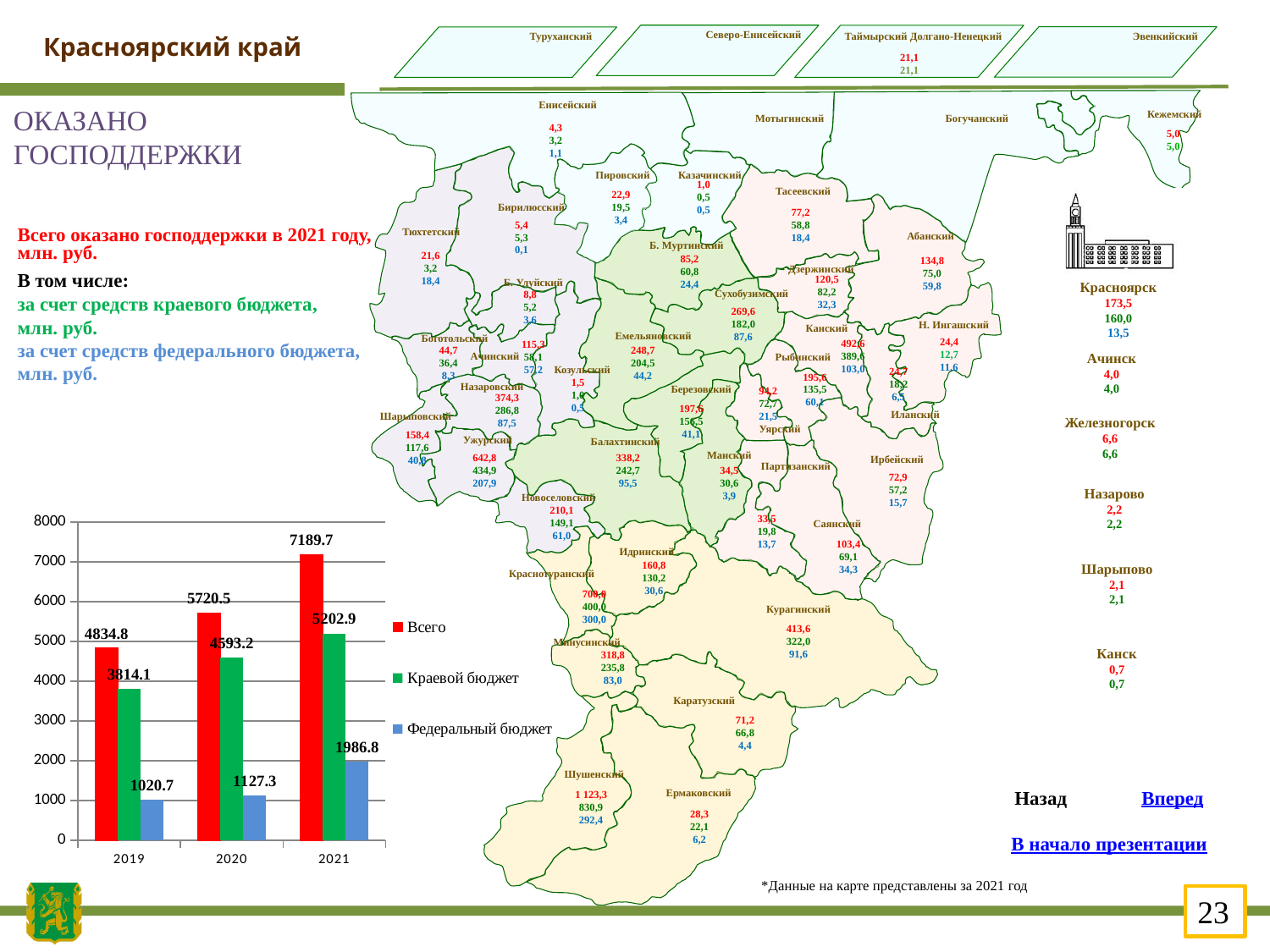
How many years are shown on the x axis of the bar chart? 3 In the bar chart, what is the difference between Всего in 2021 and Всего in 2020? 1469.2 In the bar chart, is the value of Краевой бюджет for 2021 greater or less than 5000? greater In the bar chart, what is the value of Всего for 2021? 7189.7 How many series does the legend of the bar chart list? 3 In the bar chart, which is larger: Краевой бюджет in 2020 or Всего in 2019? Всего in 2019 In the bar chart, which year has the lowest value for Федеральный бюджет? 2019 In the bar chart, what is the value of Федеральный бюджет for 2020? 1127.3 What kind of chart is shown in the lower left of the slide? bar chart In the bar chart, does the value of Всего rise or fall from 2019 to 2021? rise In the bar chart, which year has the highest value for Всего? 2021 In the bar chart, what is the value of Краевой бюджет for 2019? 3814.1